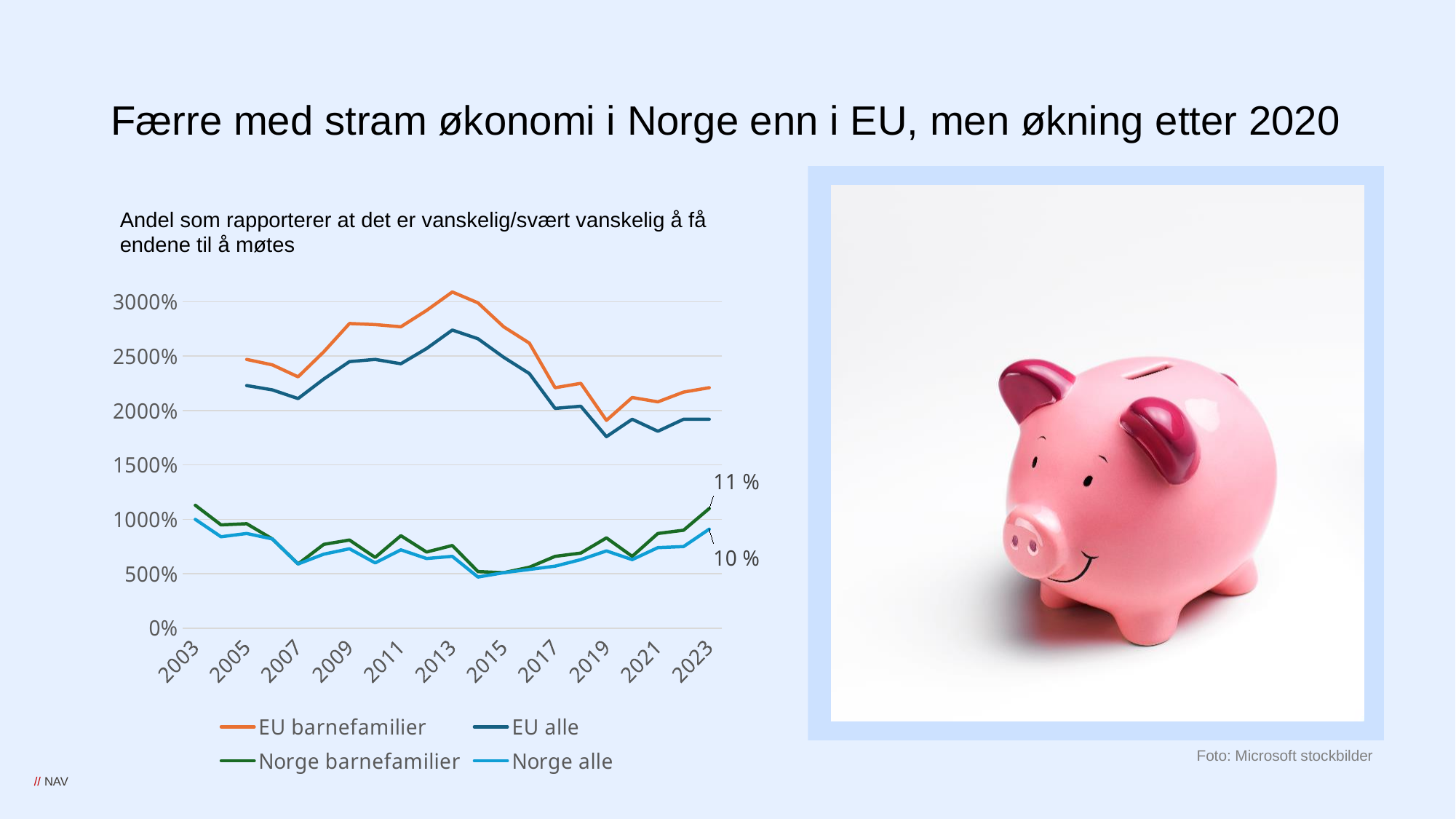
Is the value for EU barnefamilier in 2009 greater or less than 2500%? greater Does the Norge barnefamilier line rise or fall between 2019 and 2023? rise Which series has the highest value in 2013? EU barnefamilier In 2023, which is larger: Norge barnefamilier or Norge alle? Norge barnefamilier How many year labels are shown on the x axis? 11 What is the value for Norge barnefamilier in 2023? 11 % What is the value for Norge alle in 2023? 10 % What kind of chart is shown on the slide? line chart Is the value for Norge barnefamilier in 2003 greater or less than 1000%? greater Which series is drawn in orange in the legend? EU barnefamilier How many series does the chart legend list? 4 Is the value for EU alle in 2013 greater or less than 3000%? less